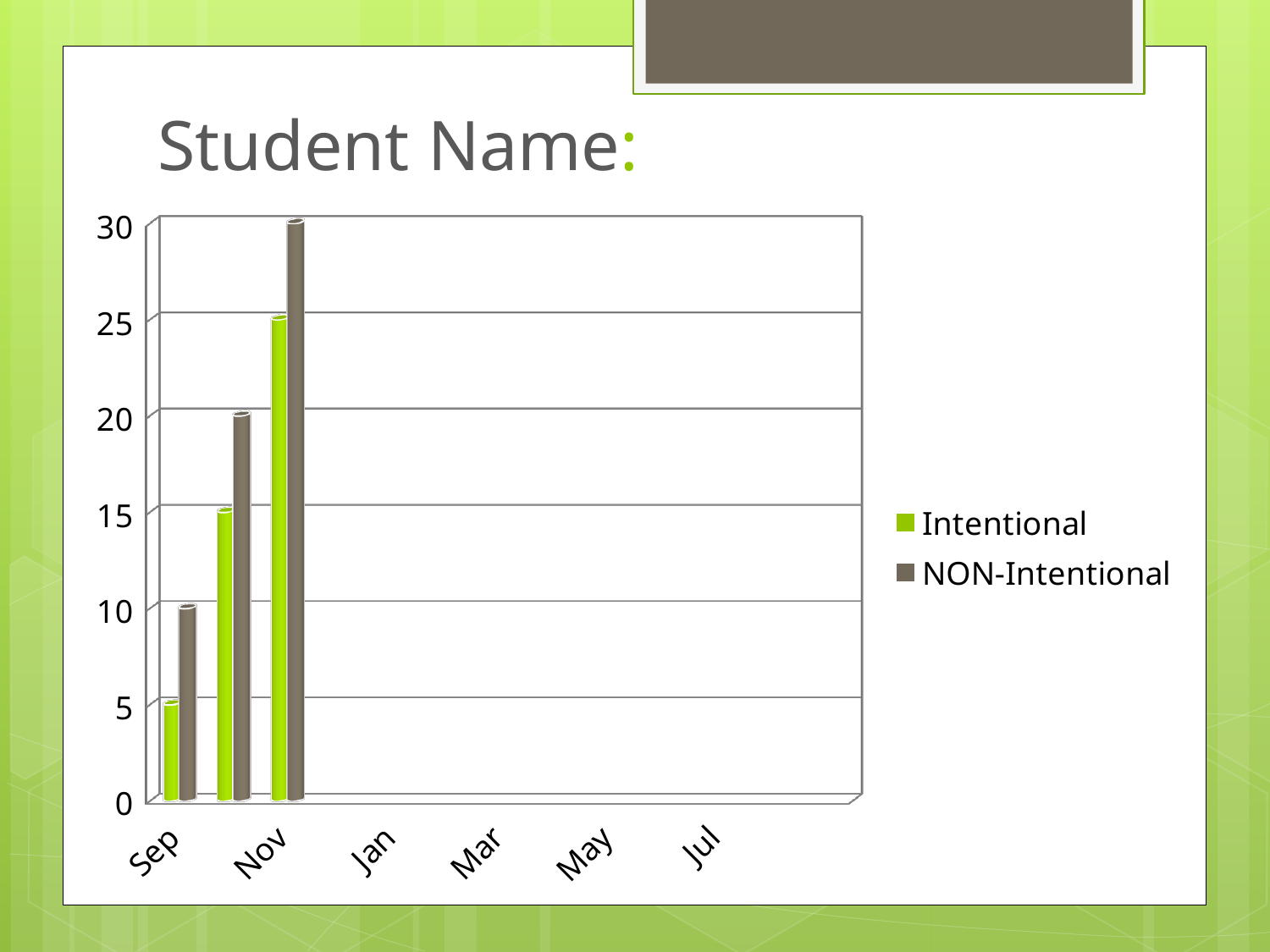
Which legend entry is shown in green? Intentional What is the difference between the NON-Intentional and Intentional values for Sep? 5 What is the Intentional value for Nov? 25 What is the Intentional value for Sep? 5 What is the NON-Intentional value for Nov? 30 What is the title of the chart? Student Name: What kind of chart is shown on the slide? bar chart What is the difference between the Intentional values for Nov and Sep? 20 Which series has the larger value for Nov, Intentional or NON-Intentional? NON-Intentional What is the NON-Intentional value for Sep? 10 Do the Intentional values rise or fall from Sep to Nov? rise How many series does the legend list? 2